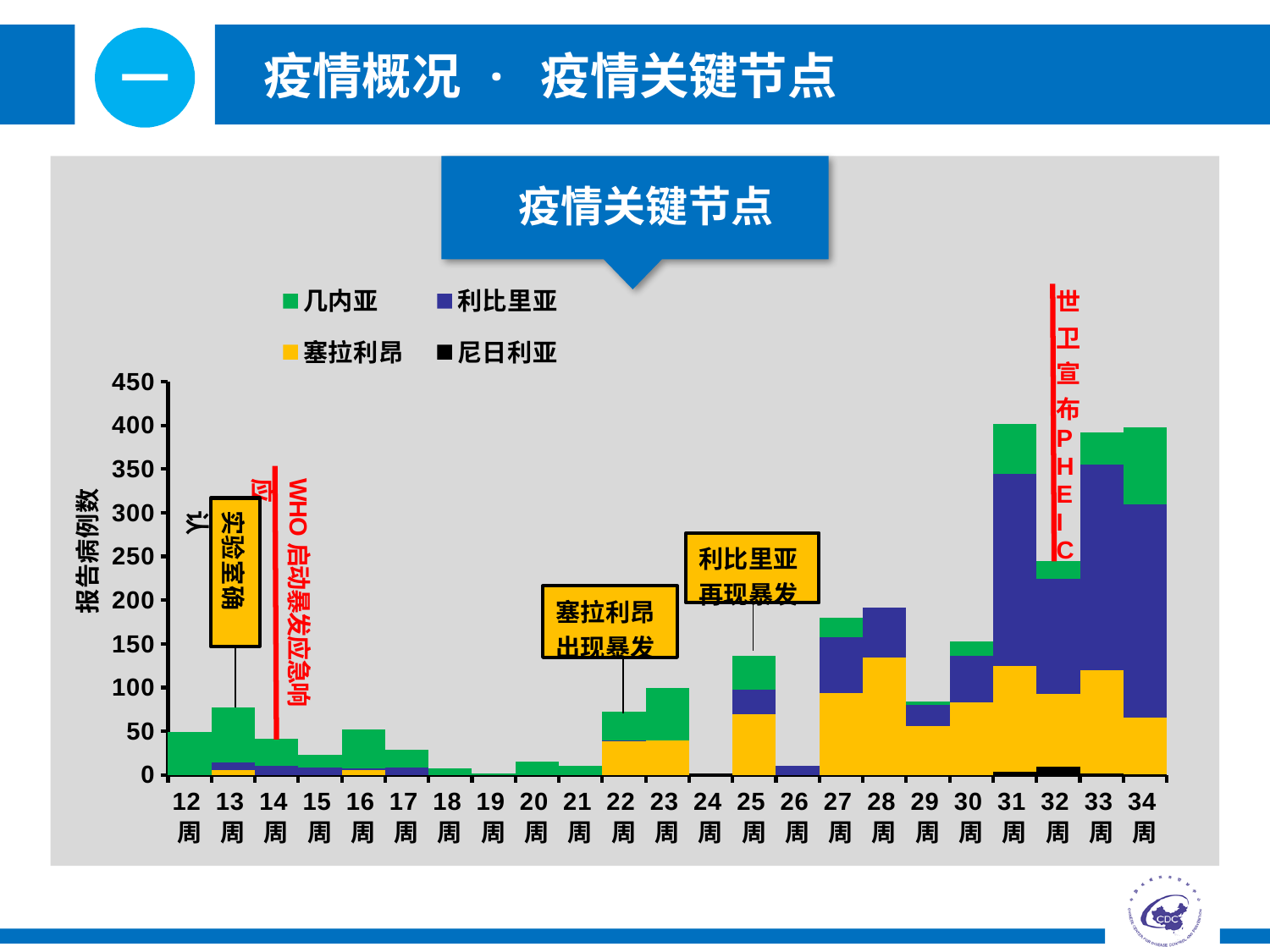
Is the total number of reported cases in week 31 (31周) greater or less than 350? greater How many series does the legend list? 4 How many weeks (categories) are shown on the x axis? 23 What kind of chart is shown on the slide? stacked bar chart Is the total number of reported cases in week 13 (13周) greater or less than 50? greater What is the label on the y axis of the chart? 报告病例数 Is the total number of reported cases in week 25 (25周) greater or less than 100? greater Which week has the larger total of reported cases, week 31 (31周) or week 32 (32周)? 31周 Which week has the larger total of reported cases, week 13 (13周) or week 14 (14周)? 13周 Do the total reported cases generally rise or fall from week 24 (24周) to week 31 (31周)? rise Which colour represents 几内亚 in the legend? green